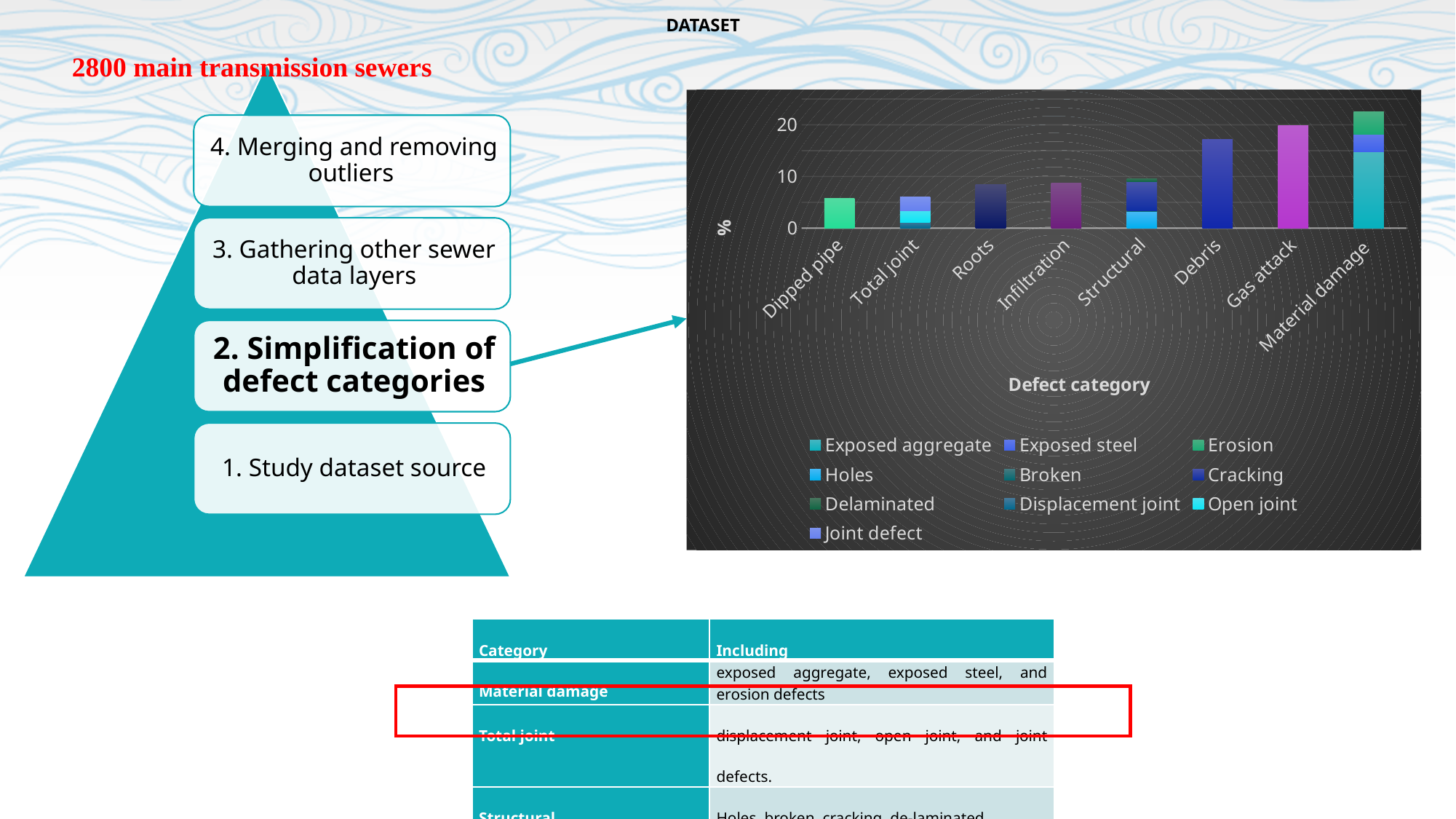
Which is larger in the chart, the value for Debris or the value for Roots? Debris How many series does the chart's legend list? 10 Is the value for Roots greater or less than 10? less Which is larger in the chart, the value for Gas attack or the value for Structural? Gas attack How many defect categories are shown on the x axis of the chart? 8 Is the value for Debris greater or less than 10? greater Which defect category has the highest total value in the chart? Material damage Is the value for Material damage greater or less than 20? greater What unit label is shown on the y axis of the chart? % What is the title of the x axis of the chart? Defect category What kind of chart is shown on the slide? bar chart